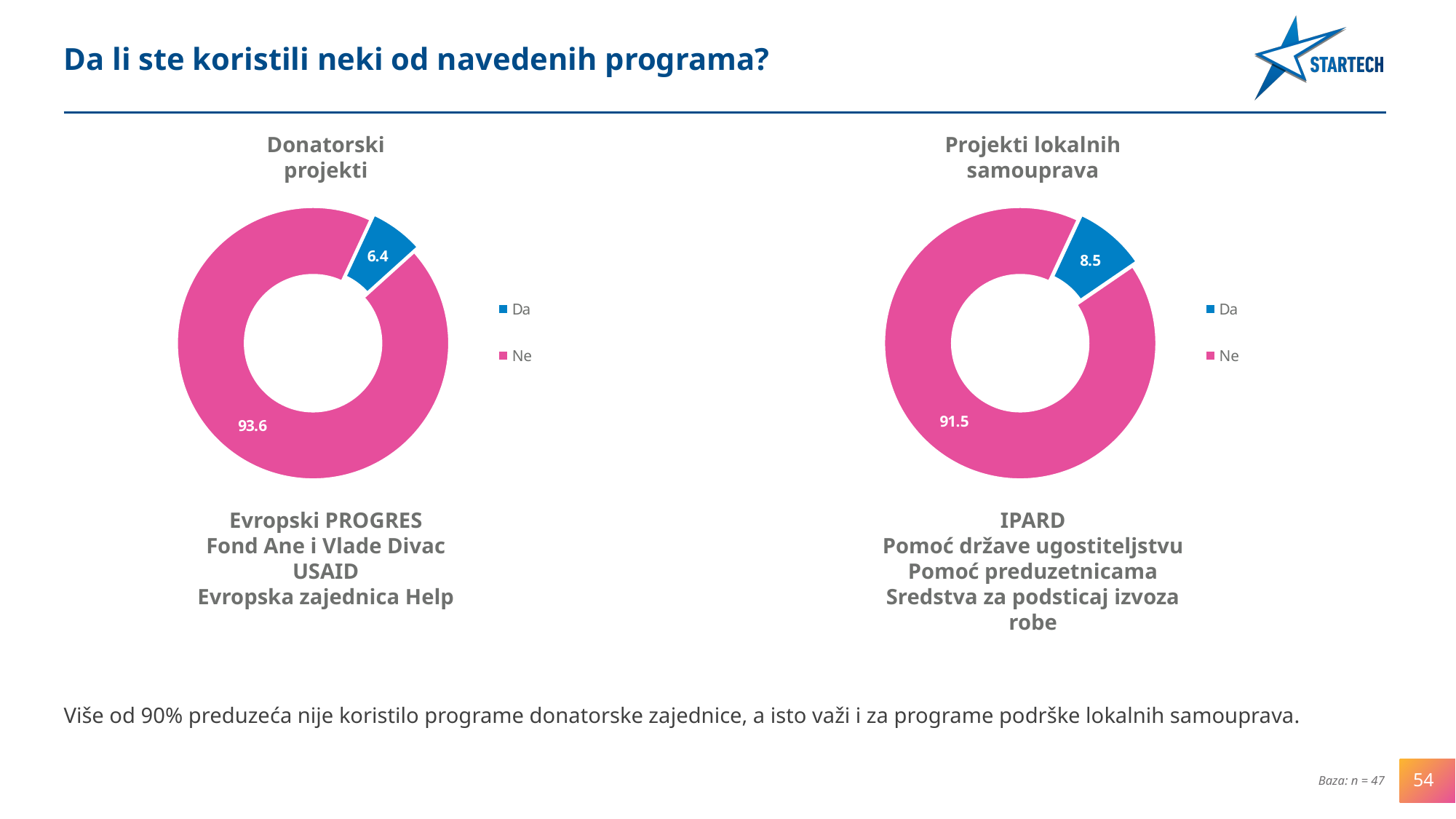
In the 'Donatorski projekti' chart, what is the difference between the 'Ne' and 'Da' values? 87.2 In the 'Projekti lokalnih samouprava' chart, what is the value for 'Da'? 8.5 In the 'Donatorski projekti' chart, what colour is the 'Ne' slice? Pink In the 'Donatorski projekti' chart, what is the value for 'Ne'? 93.6 In the 'Donatorski projekti' chart, what is the value for 'Da'? 6.4 What type of chart is the 'Donatorski projekti' chart? Doughnut chart In the 'Donatorski projekti' chart, which category has the largest share? Ne In the 'Projekti lokalnih samouprava' chart, what is the value for 'Ne'? 91.5 How many categories does the legend of the 'Projekti lokalnih samouprava' chart list? 2 In the 'Projekti lokalnih samouprava' chart, what is the difference between the 'Ne' and 'Da' values? 83 In the 'Projekti lokalnih samouprava' chart, which category has the smallest share? Da Which chart has the larger 'Da' value, 'Donatorski projekti' or 'Projekti lokalnih samouprava'? Projekti lokalnih samouprava